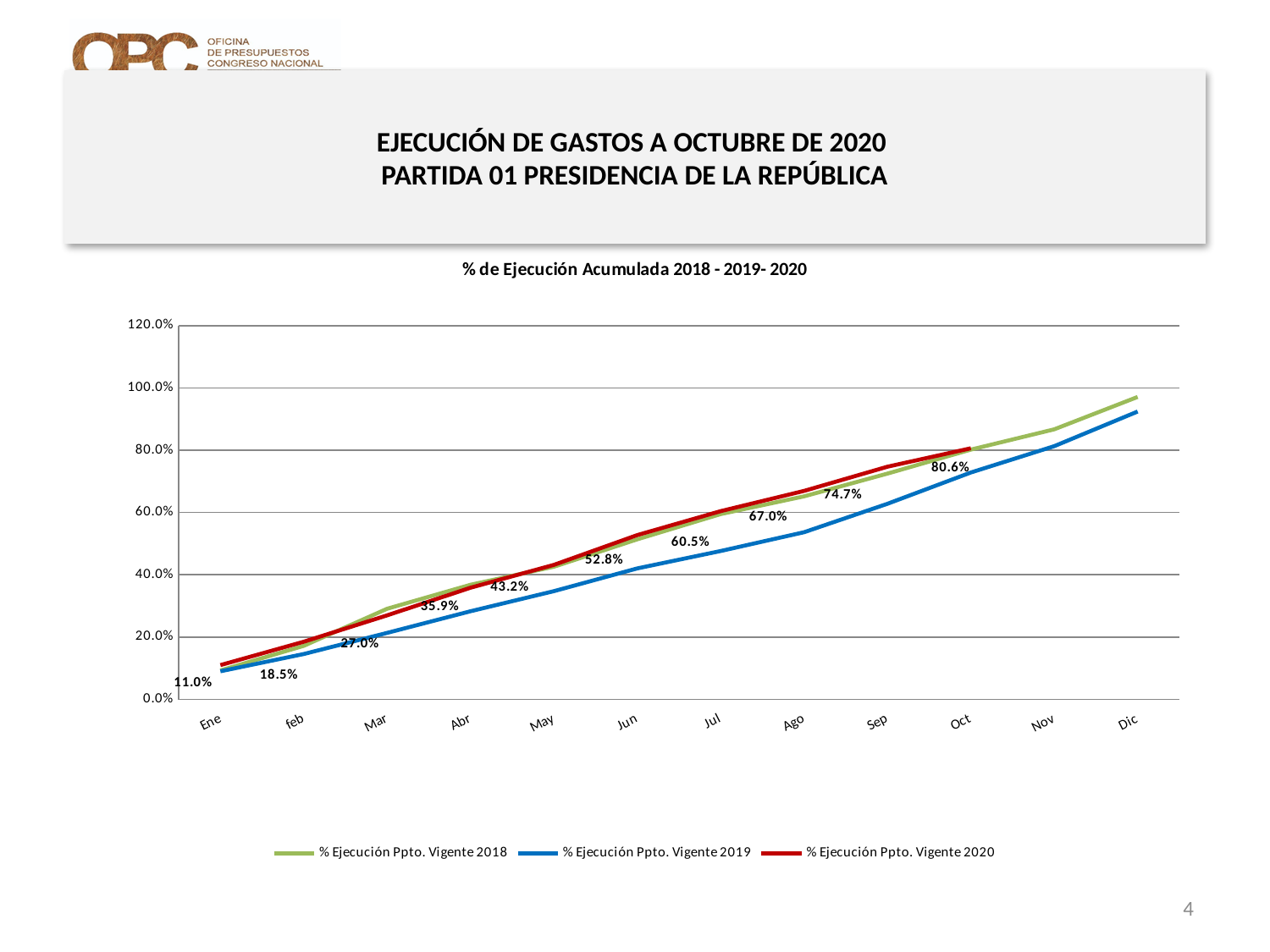
What is the difference between the % Ejecución Ppto. Vigente 2020 values for Oct and Sep? 5.9% What is the value for % Ejecución Ppto. Vigente 2020 in Oct? 80.6% How many months are shown on the x axis? 12 What is the title of the chart? % de Ejecución Acumulada 2018 - 2019- 2020 What type of chart is shown on the slide? line chart What is the value for % Ejecución Ppto. Vigente 2020 in Ene? 11.0% What is the difference between the % Ejecución Ppto. Vigente 2020 values for Abr and Mar? 8.9% How many series does the legend list? 3 What is the value for % Ejecución Ppto. Vigente 2020 in Jun? 52.8% Does the % Ejecución Ppto. Vigente 2020 series rise or fall from Ene to Oct? rise Is the value for % Ejecución Ppto. Vigente 2019 in Dic greater or less than 80.0%? greater Which series is higher in Ago, % Ejecución Ppto. Vigente 2020 or % Ejecución Ppto. Vigente 2019? % Ejecución Ppto. Vigente 2020